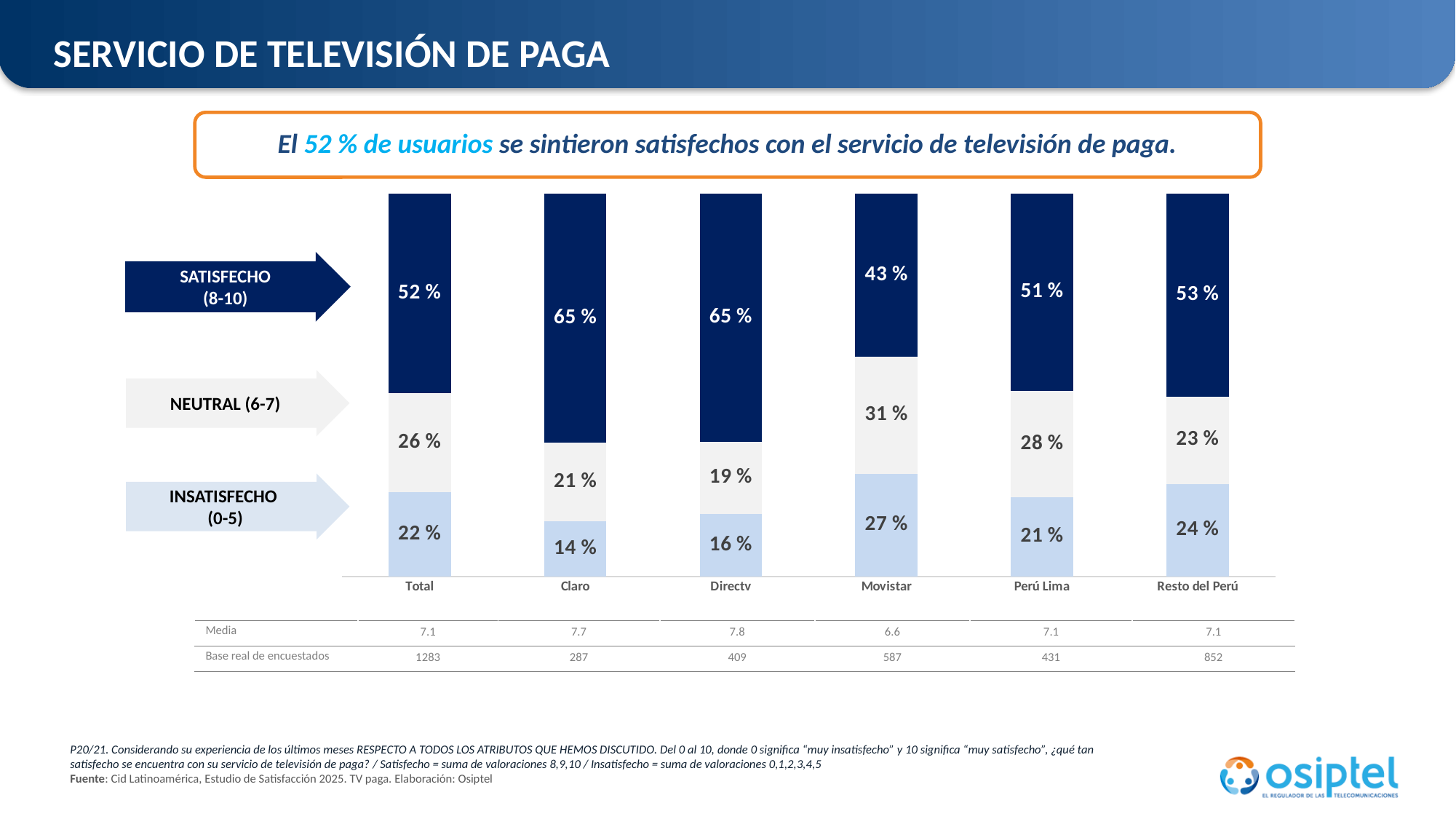
What is the Media (mean) value shown for Directv? 7.8 How many categories are shown on the x axis of the chart? 6 How many series does the chart show? 3 Which category has the lowest Insatisfecho (0-5) percentage? Claro Which category has the lowest Satisfecho (8-10) percentage? Movistar What is the Insatisfecho (0-5) value for Movistar? 27 % Which category has the highest Neutral (6-7) percentage? Movistar Which has a larger Insatisfecho (0-5) percentage, Perú Lima or Resto del Perú? Resto del Perú What is the difference between the Satisfecho (8-10) percentages for Claro and Movistar? 22 % What kind of chart is shown on the slide? Stacked bar chart What is the Neutral (6-7) value for Resto del Perú? 23 % What percentage of Total users are Satisfecho (8-10)? 52 %